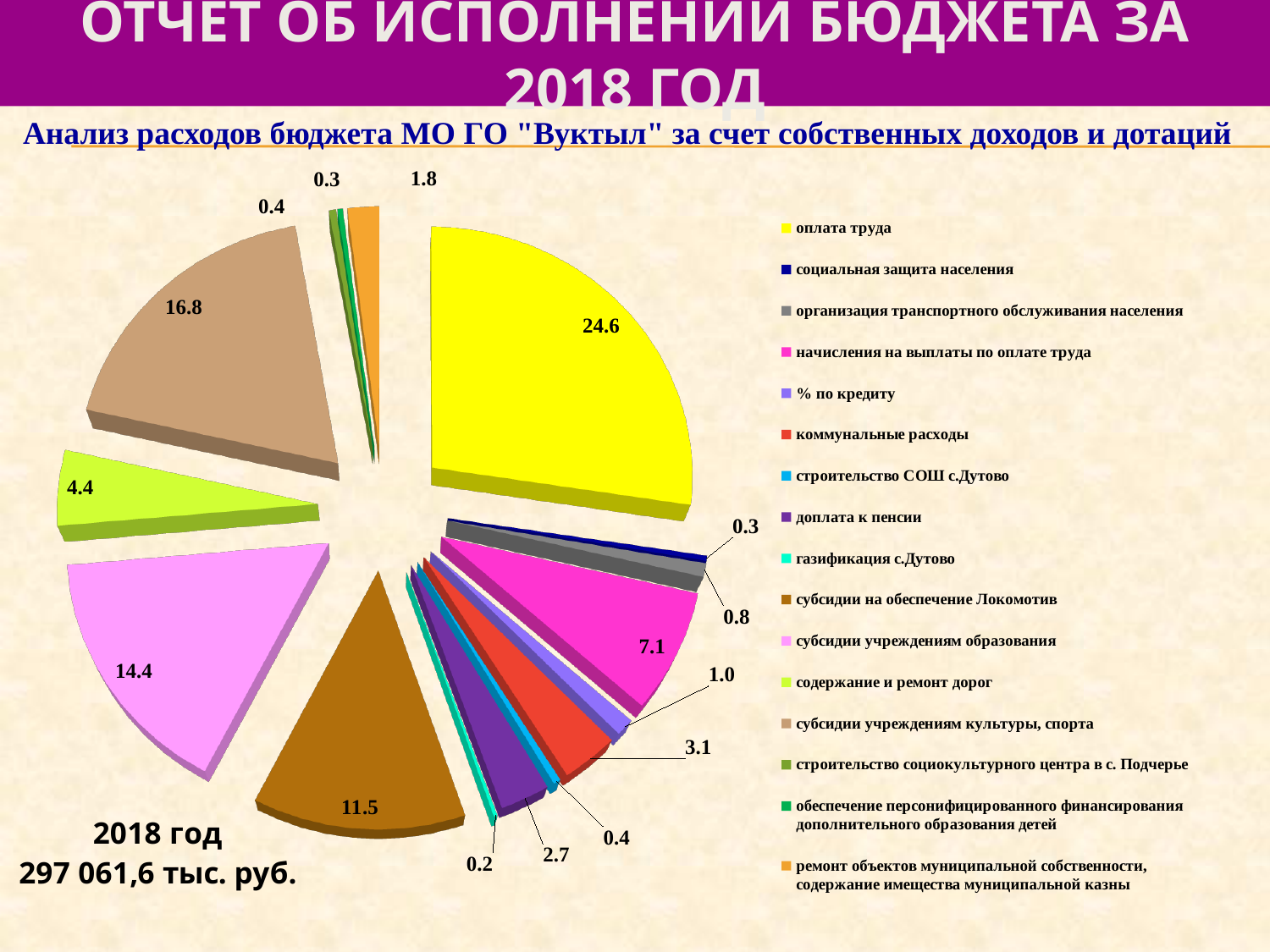
Which category has the smallest slice of the pie? газификация с.Дутово Which is larger: 'субсидии учреждениям образования' or 'субсидии на обеспечение Локомотив'? субсидии учреждениям образования What is the value shown for the 'субсидии на обеспечение Локомотив' slice? 11.5 What is the value shown for the 'субсидии учреждениям образования' slice? 14.4 What is the value shown for the 'содержание и ремонт дорог' slice? 4.4 What is the value shown for the 'коммунальные расходы' slice? 3.1 What type of chart is shown on the slide? pie chart Which category has the largest slice of the pie? оплата труда What is the difference between the values for 'оплата труда' and 'субсидии учреждениям культуры, спорта'? 7.8 What is the value shown for the 'оплата труда' slice? 24.6 How many categories does the legend list? 16 What is the value shown for the 'субсидии учреждениям культуры, спорта' slice? 16.8